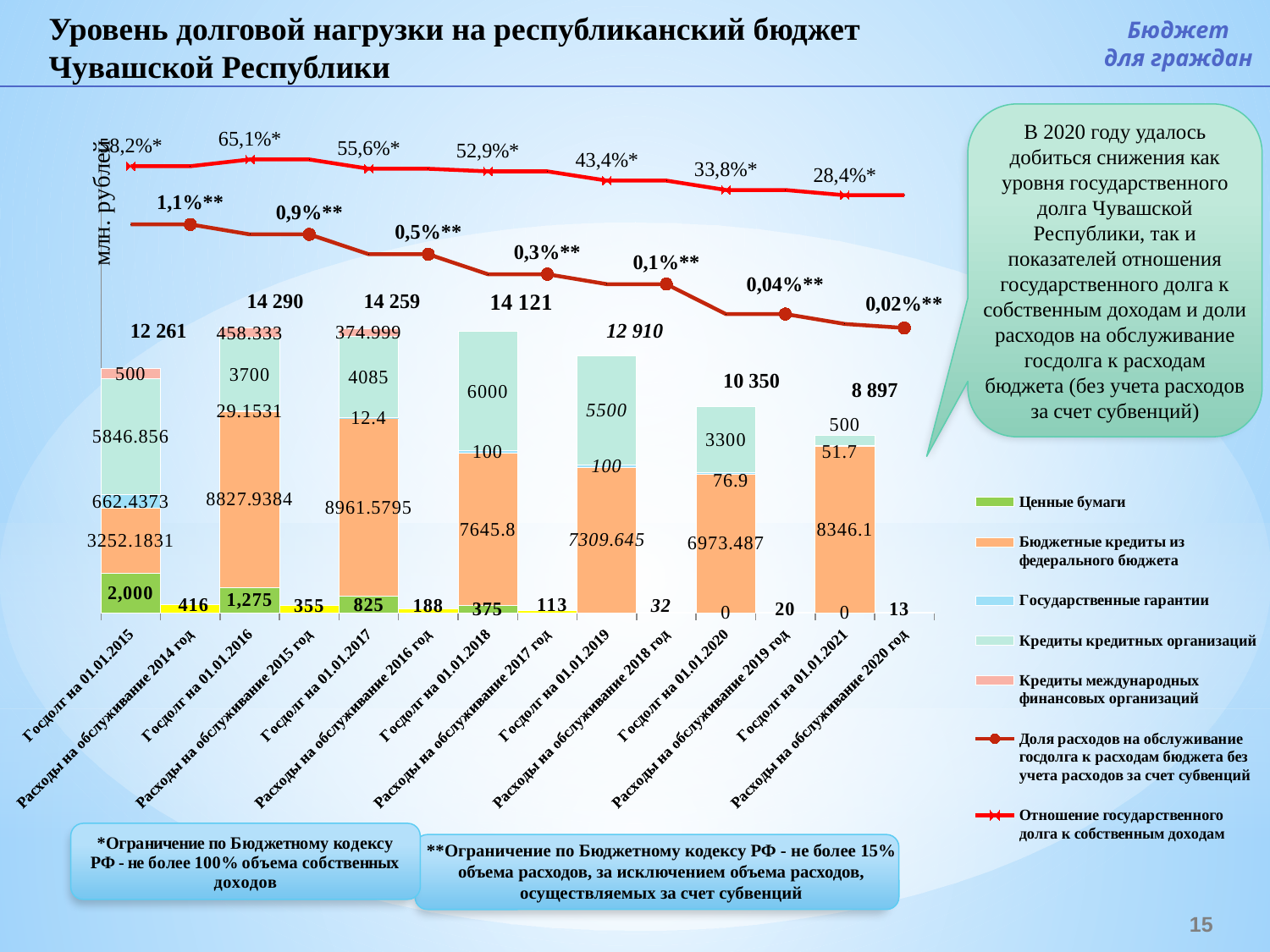
What is the difference between the debt service expenses for 2014 (416) and for 2020 (13)? 403 What is the value of Бюджетные кредиты из федерального бюджета at 01.01.2021? 8346.1 Which is larger: Кредиты кредитных организаций at 01.01.2018 or at 01.01.2019? 01.01.2018 What is the share of debt service expenses in budget expenses (Доля расходов на обслуживание госдолга) at 01.01.2021? 0,02% How many entries does the legend list? 7 Does the line for Доля расходов на обслуживание госдолга rise or fall from 01.01.2015 to 01.01.2021? fall What is the ratio of state debt to own income (Отношение государственного долга к собственным доходам) at 01.01.2016? 65,1% What is the value shown for Расходы на обслуживание 2014 год? 416 On which date is the total state debt (Госдолг) the lowest? Госдолг на 01.01.2021 What is the total state debt (Госдолг) shown for 01.01.2016? 14 290 What kind of chart is shown on the slide? Stacked bar chart combined with line chart On which date is the total state debt (Госдолг) the highest? Госдолг на 01.01.2016